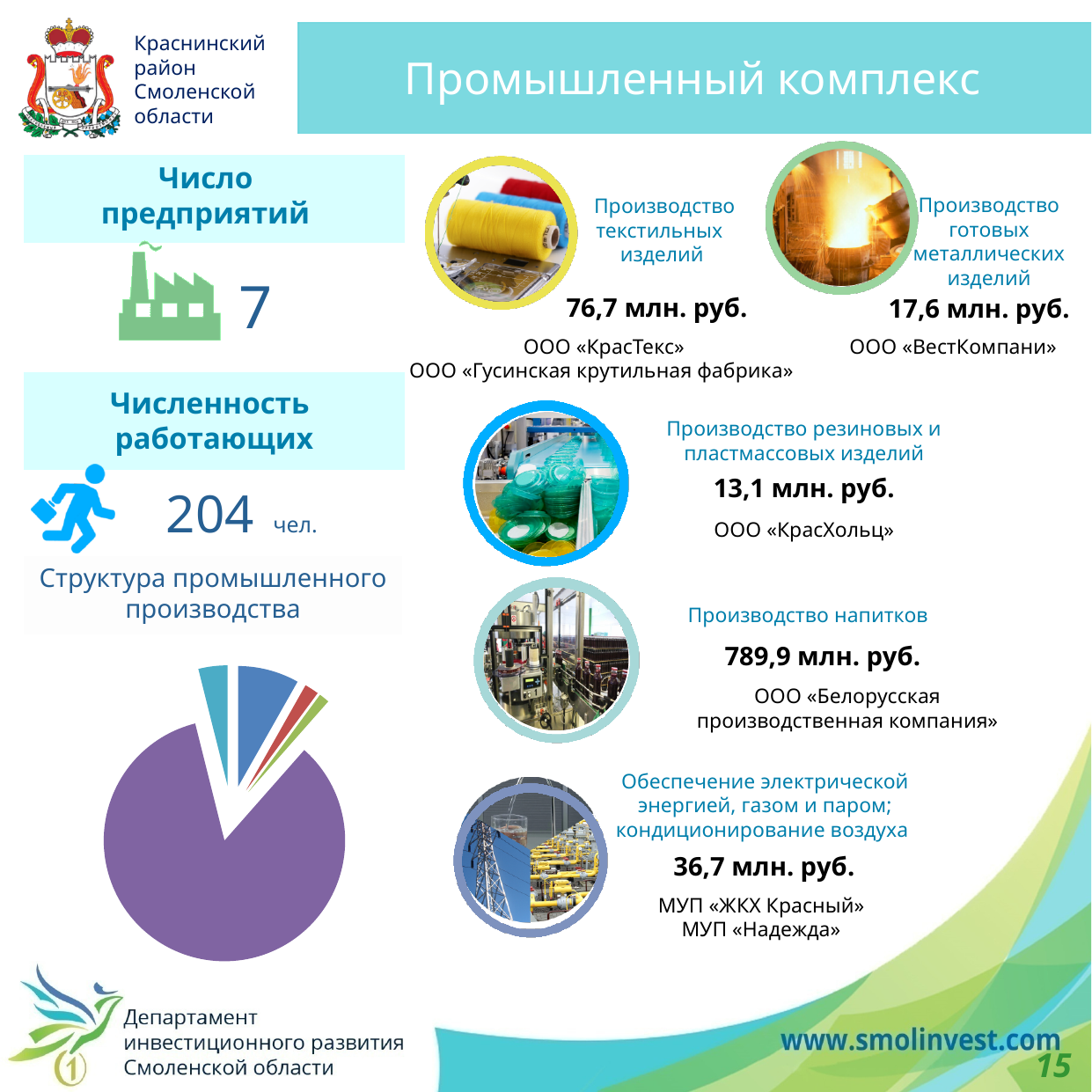
Which colour slice is the largest in the pie chart «Структура промышленного производства»? purple What kind of chart is shown under the heading «Структура промышленного производства»? pie chart What is the title shown above the pie chart? Структура промышленного производства How many slices does the pie chart «Структура промышленного производства» have? 5 In the pie chart «Структура промышленного производства», is the purple slice's share greater or less than 50%? greater In the pie chart «Структура промышленного производства», which is larger: the purple slice or the blue slice? purple Does the pie chart «Структура промышленного производства» display a legend? No